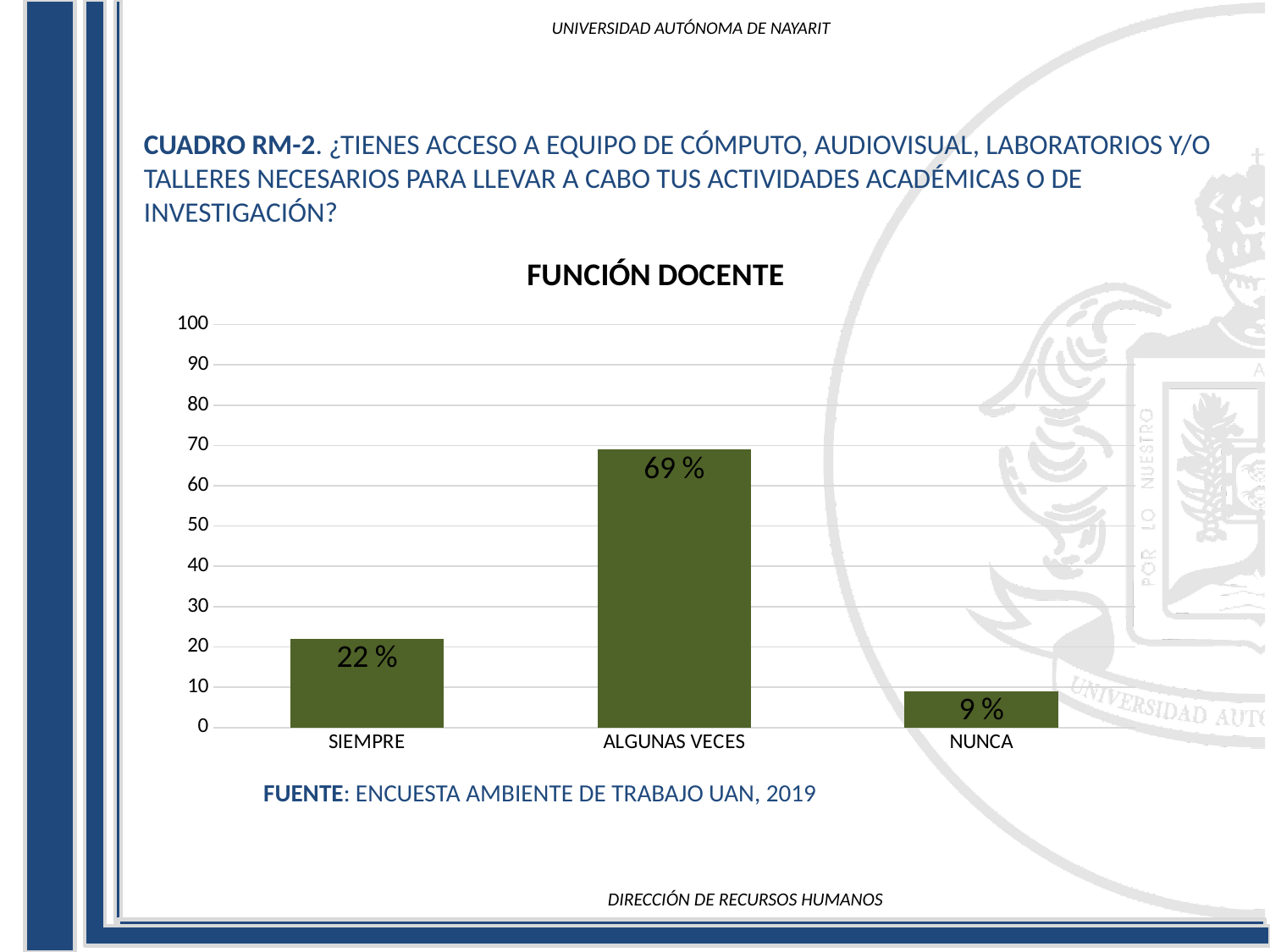
Which category has the lowest value? NUNCA What is the value for ALGUNAS VECES? 69 % What is the difference between the values for SIEMPRE and NUNCA? 13 % What is the value for NUNCA? 9 % What is the difference between the values for ALGUNAS VECES and SIEMPRE? 47 % Is the value for ALGUNAS VECES greater or less than 60? greater Which category has the highest value? ALGUNAS VECES What is the title of the chart? FUNCIÓN DOCENTE What is the value for SIEMPRE? 22 % Which is larger, the value for SIEMPRE or the value for NUNCA? SIEMPRE How many categories are shown on the x axis? 3 What kind of chart is shown on the slide? bar chart